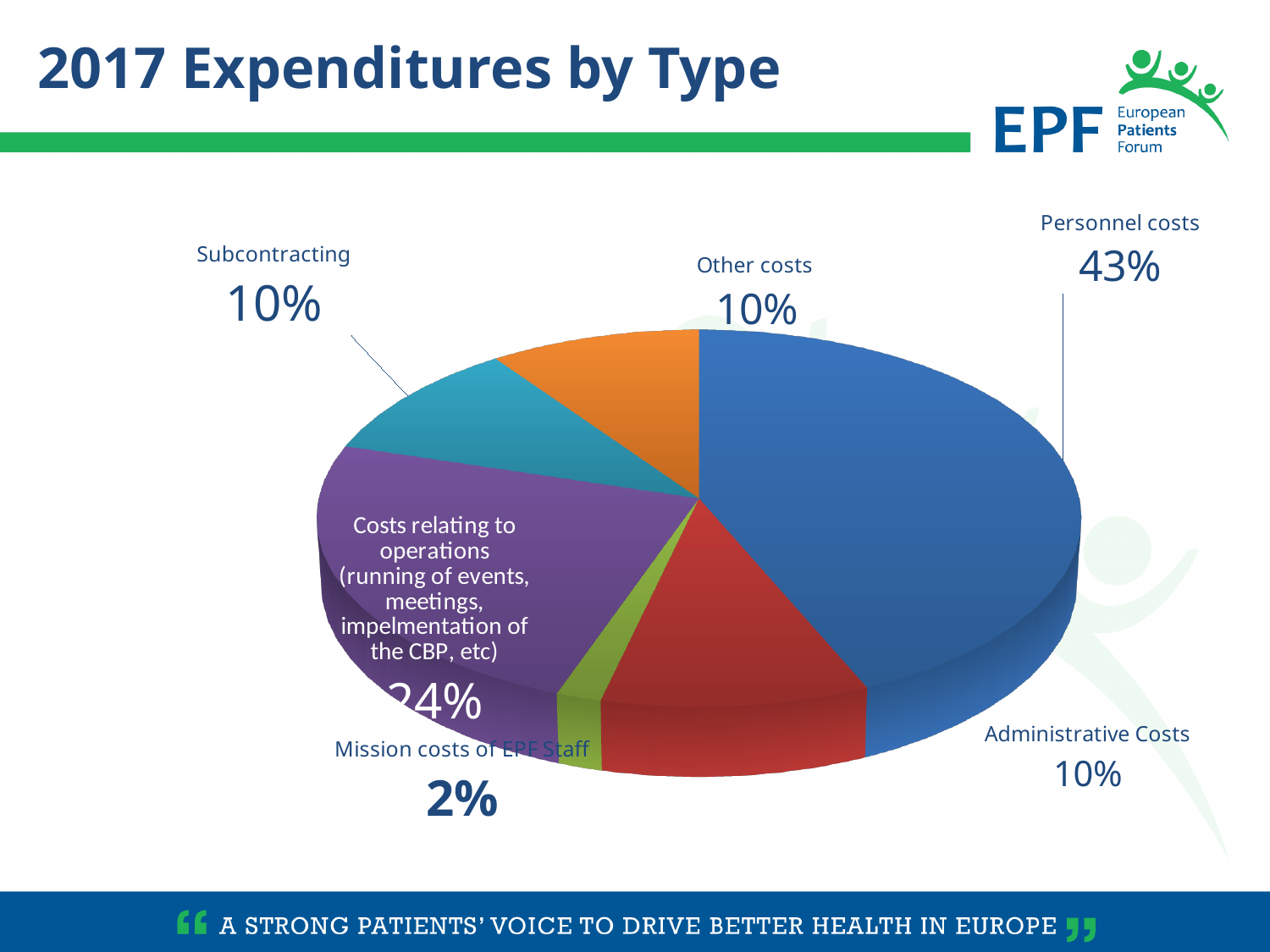
What type of chart is shown on the slide? pie chart How many slices does the pie chart have? 6 What share of 2017 expenditures is Subcontracting? 10% What share of 2017 expenditures is Other costs? 10% Which expenditure type has the largest share? Personnel costs What share of 2017 expenditures is Administrative Costs? 10% What is the title of the chart? 2017 Expenditures by Type What share of 2017 expenditures is Personnel costs? 43% Which is larger: the share for Personnel costs or the share for Costs relating to operations? Personnel costs What is the difference in percentage points between Personnel costs and Administrative Costs? 33 What share of 2017 expenditures is Mission costs of EPF Staff? 2% Which expenditure type has the smallest share? Mission costs of EPF Staff